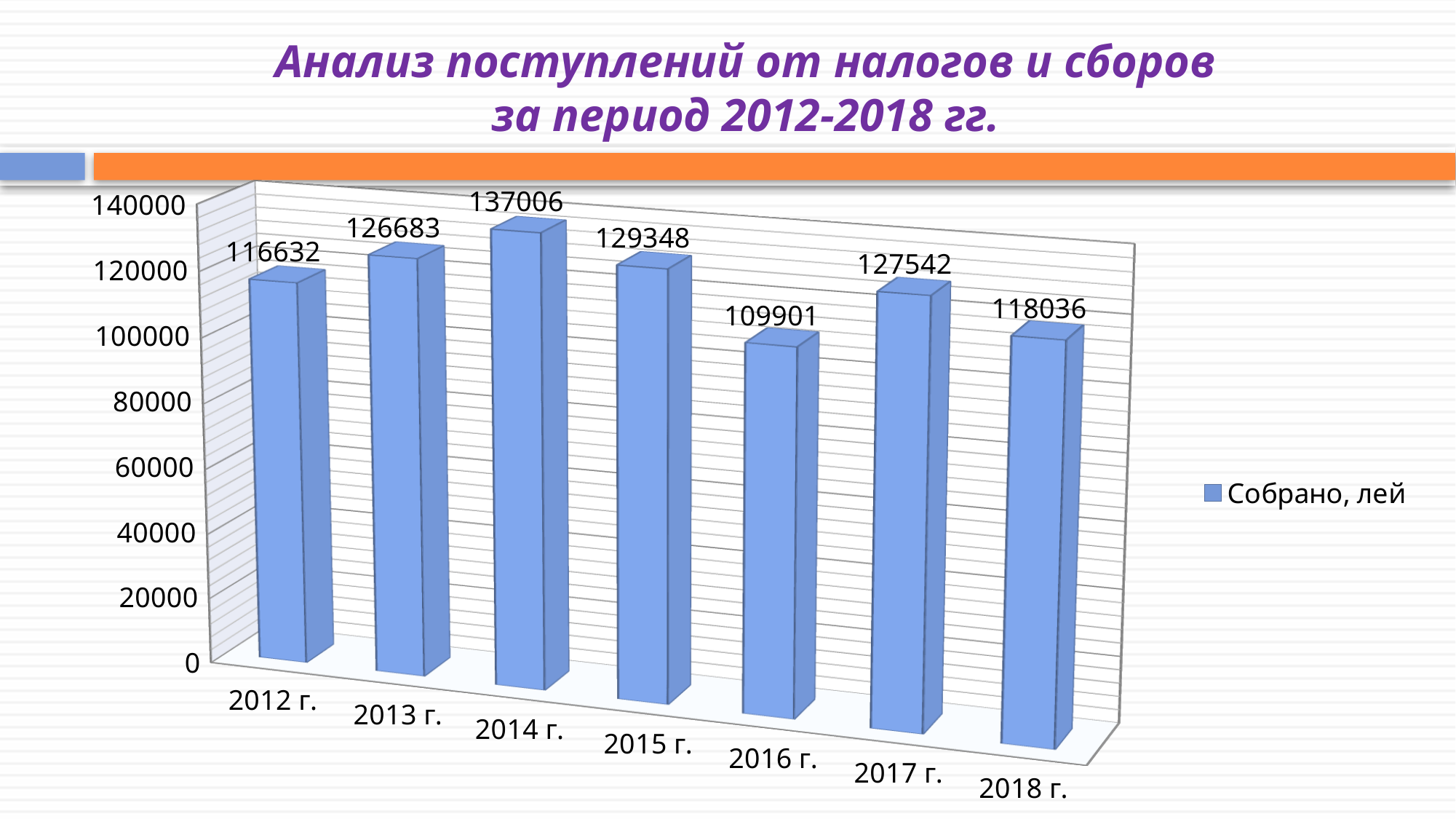
Do the values rise or fall from 2012 г. to 2014 г.? Rise Which year has the highest value? 2014 г. How many years are shown on the x axis? 7 What is the difference between the values for 2013 г. and 2012 г.? 10051 What kind of chart is shown on the slide? Bar chart How many series does the legend list? 1 What is the value for 2016 г.? 109901 Which is larger, the value for 2013 г. or the value for 2018 г.? 2013 г. What is the value for 2018 г.? 118036 What is the difference between the values for 2014 г. and 2016 г.? 27105 What is the value for 2014 г.? 137006 Which year has the lowest value? 2016 г.